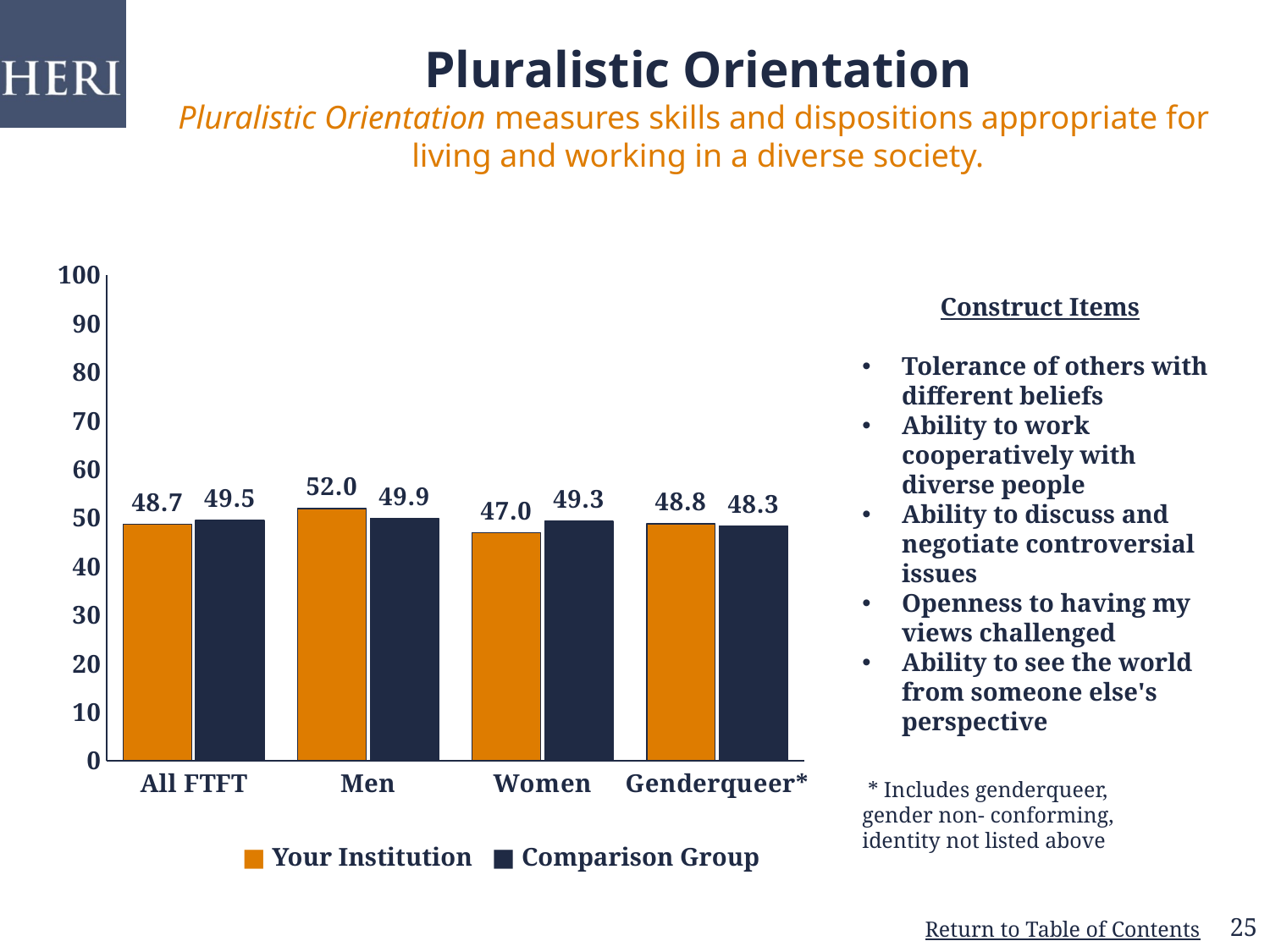
How many categories are shown on the x axis? 4 What is the difference between the Comparison Group and Your Institution values for Women? 2.3 Which category has the highest Your Institution value? Men How many series does the legend list? 2 What colour represents Your Institution in the chart? orange Which category has the lowest Your Institution value? Women What is the Your Institution value for Genderqueer*? 48.8 What is the Comparison Group value for Women? 49.3 What is the Your Institution value for Men? 52.0 For Genderqueer*, which is larger: Your Institution or Comparison Group? Your Institution What kind of chart is shown on the slide? bar chart Is the Your Institution value for Women greater or less than 50? less